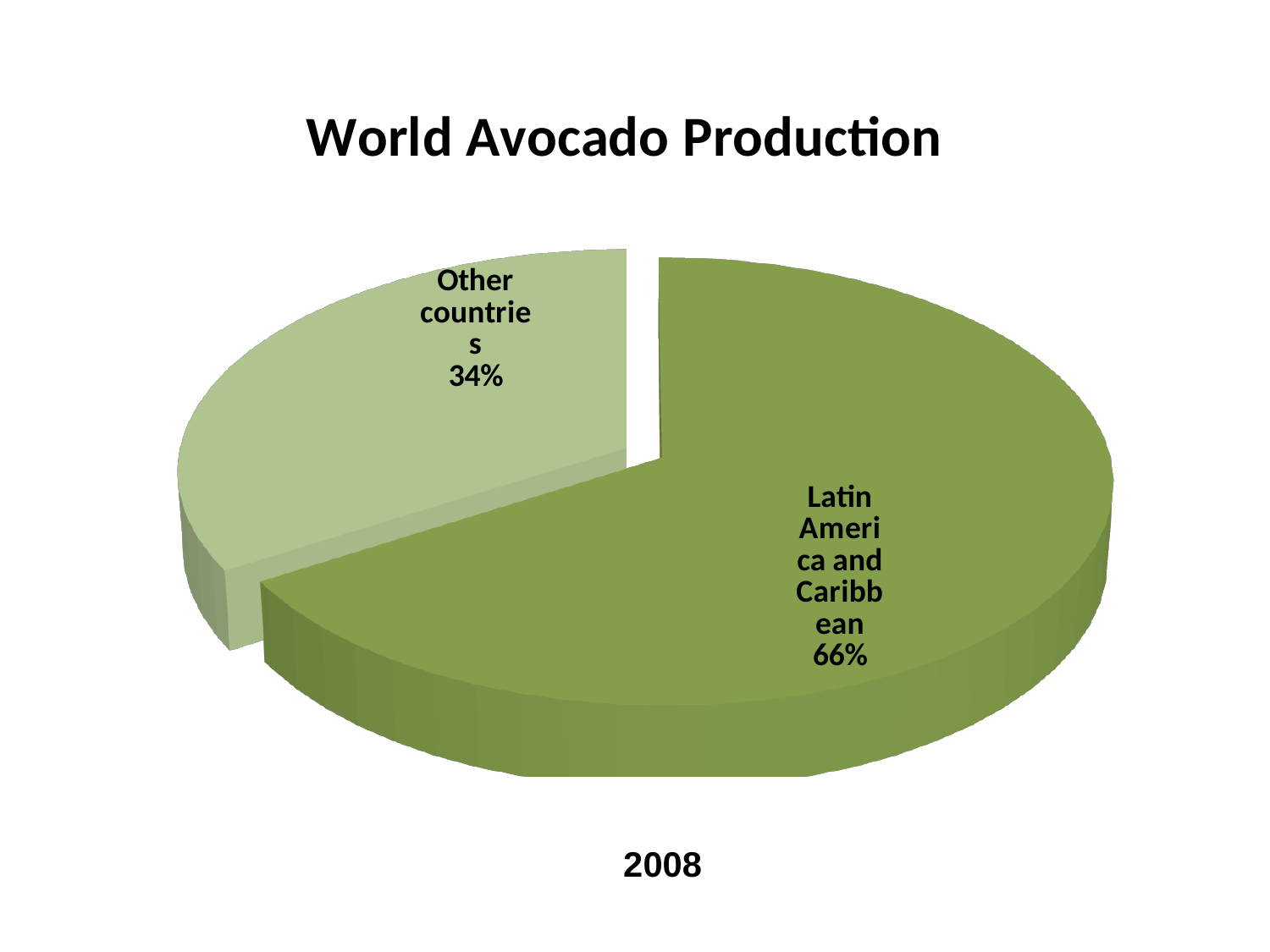
What share of world avocado production do Other countries account for? 34% Is the share for Other countries greater or less than 50%? less What is the total of the two slices' percentages? 100% Which slice of the pie is the smallest? Other countries Which slice of the pie is the largest? Latin America and Caribbean Which year does the chart's data refer to? 2008 What kind of chart is shown on the slide? Pie chart Which is larger: the share for Latin America and Caribbean or the share for Other countries? Latin America and Caribbean How many slices does the pie chart have? 2 What is the difference in percentage points between the Latin America and Caribbean share and the Other countries share? 32 What is the title of the chart? World Avocado Production What share of world avocado production does Latin America and Caribbean account for? 66%